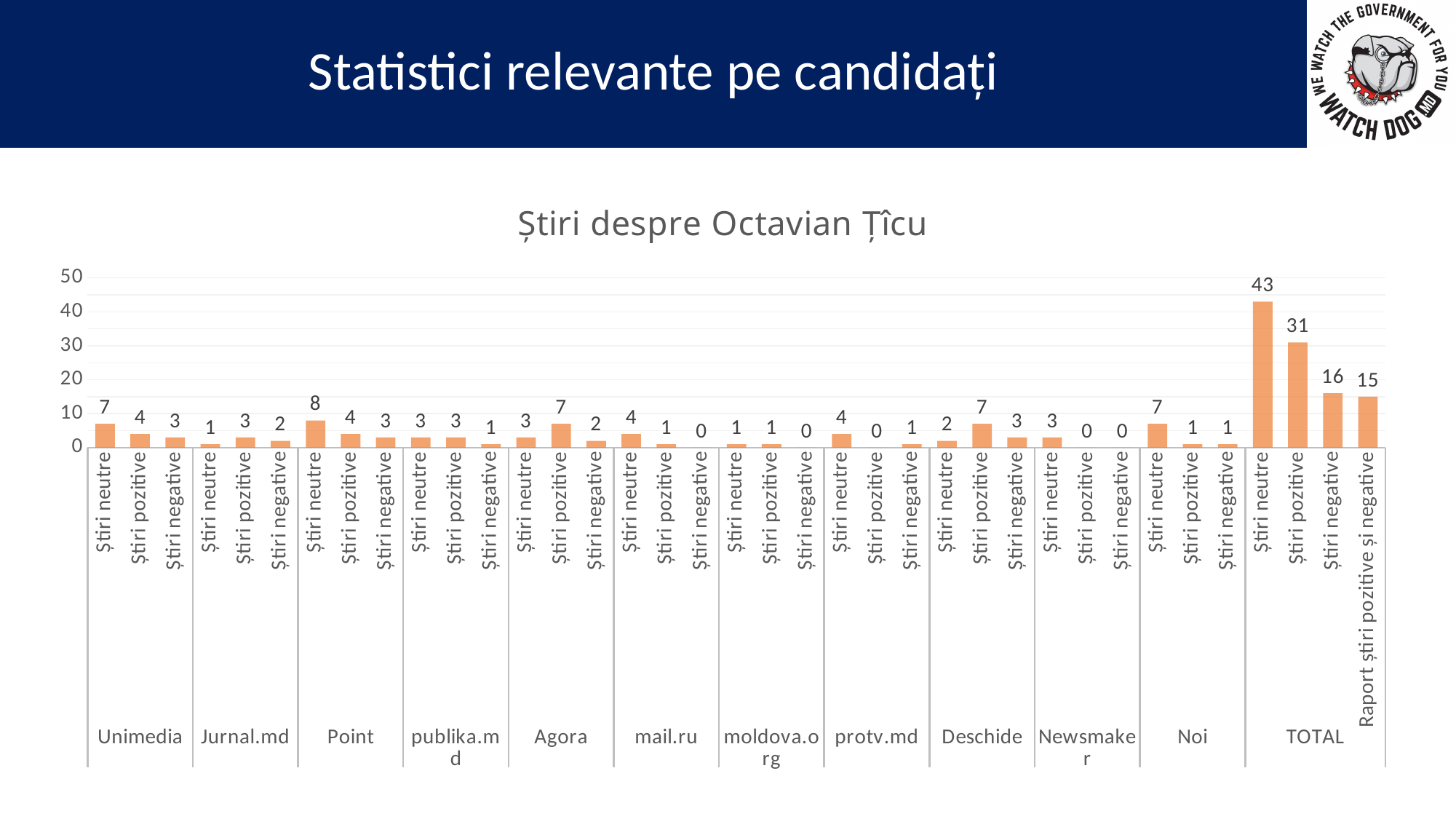
What is the value for Știri negative at mail.ru? 0 Which is larger: Știri neutre at Unimedia or Știri neutre at Jurnal.md? Știri neutre at Unimedia What is the value for Știri neutre at Point? 8 What is the title of the chart? Știri despre Octavian Țîcu What is the value for Raport știri pozitive și negative in the TOTAL group? 15 How many news outlet groups, including TOTAL, are shown on the x axis? 12 What is the value for Știri negative in the TOTAL group? 16 What is the difference between Știri neutre and Știri pozitive in the TOTAL group? 12 Which bar has the highest value in the chart? Știri neutre (TOTAL) What is the value for Știri pozitive at Agora? 7 What kind of chart is shown on the slide? Bar chart Is the value for Știri pozitive in the TOTAL group greater or less than 20? greater